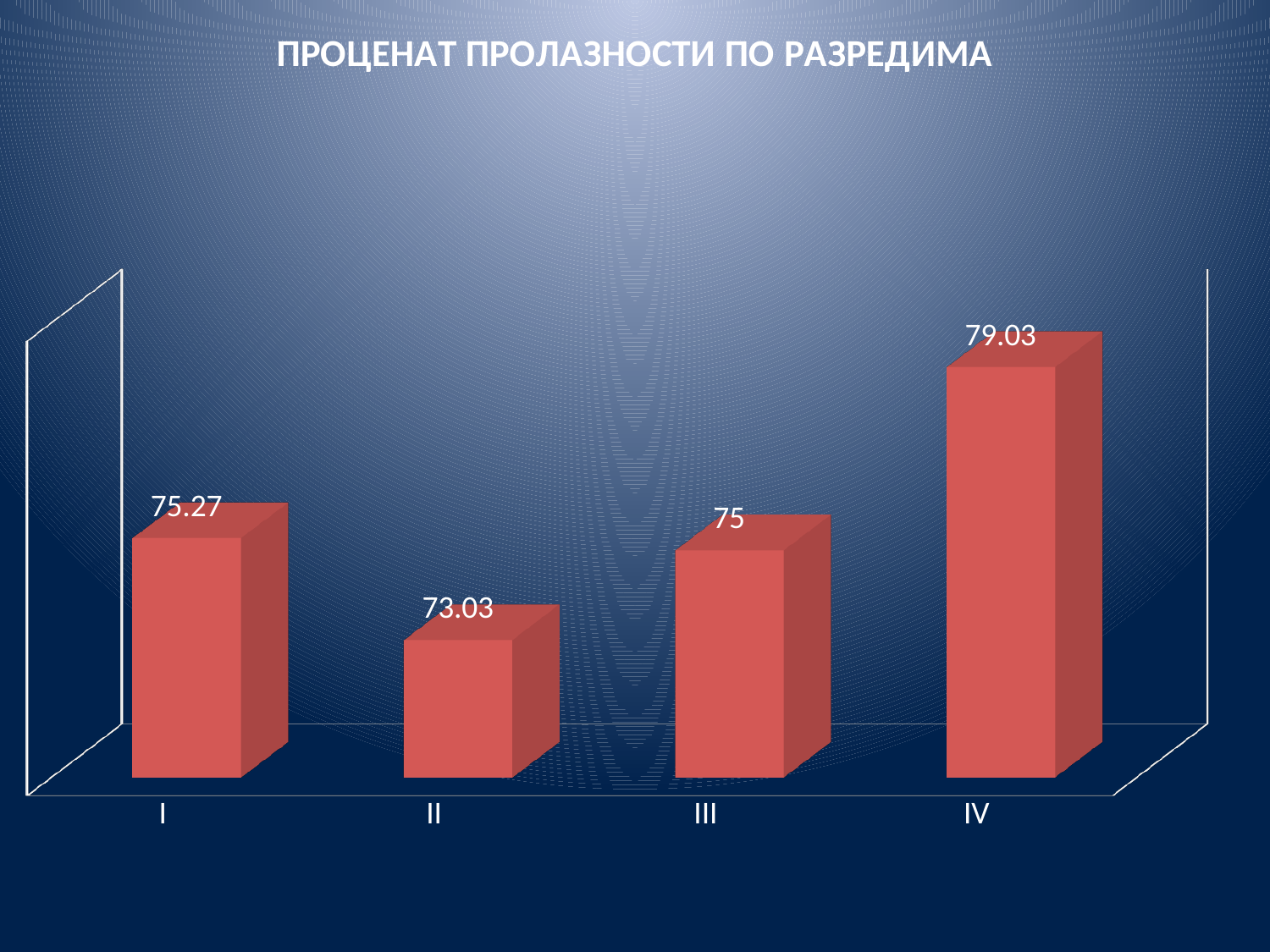
What is the value for category I? 75.27 What kind of chart is shown on the slide? bar chart Which category has the lowest value? II What is the value for category IV? 79.03 How many categories are shown on the x axis? 4 What is the title of the chart? ПРОЦЕНАТ ПРОЛАЗНОСТИ ПО РАЗРЕДИМА What is the difference between the values for I and III? 0.27 What is the difference between the values for IV and II? 6 Which category has the highest value? IV Which is larger, the value for I or the value for II? I What is the value for category III? 75 What is the value for category II? 73.03